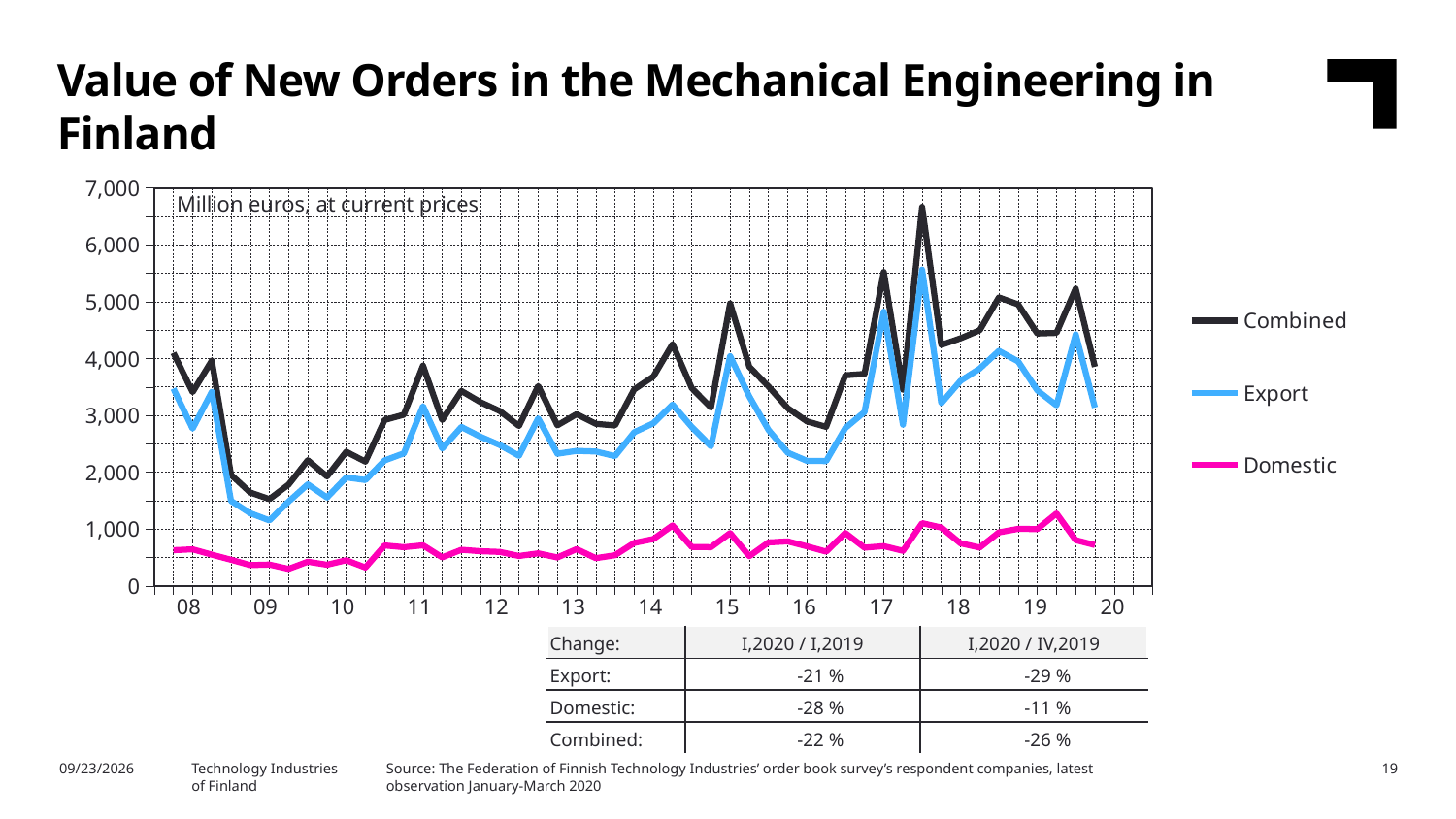
Is the peak value of the Domestic series greater or less than 2,000? less Does the Combined series rise or fall between 16 and 17? rise Which series has the lowest values throughout the chart? Domestic Which series has the highest values throughout the chart? Combined What kind of chart is shown on the slide? line chart Which series is larger, Export or Domestic? Export What unit is stated inside the chart area? Million euros, at current prices Is the peak value of the Combined series greater or less than 6,000? greater Is the peak value of the Export series greater or less than 5,000? greater Does the Combined series rise or fall between 08 and 09? fall What colour is the Domestic line in the legend? pink How many series does the legend list? 3